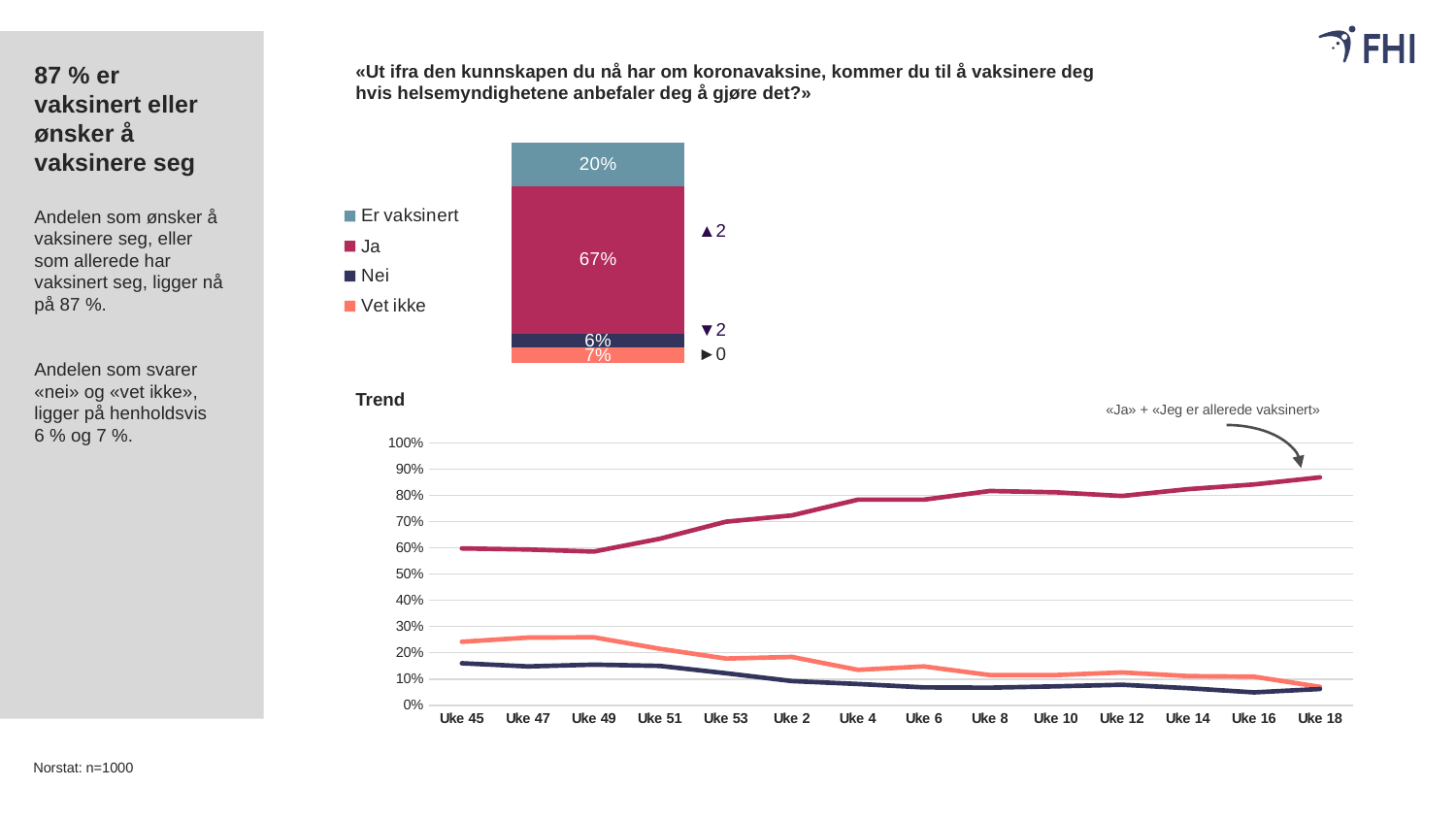
How many categories does the legend of the stacked bar chart list? 4 In the Trend chart, how many weeks are shown on the x axis? 14 In the stacked bar chart, what percentage answered "Ja"? 67% In the stacked bar chart, which category has the smallest share? Nei In the Trend chart, is the value of the top line ("Ja" + "Jeg er allerede vaksinert") at Uke 18 greater or less than 80%? greater In the stacked bar chart, what percentage answered "Vet ikke"? 7% In the stacked bar chart, what is the difference between the "Ja" share and the "Er vaksinert" share? 47 percentage points In the stacked bar chart, what percentage is shown for "Er vaksinert"? 20% In the Trend chart, does the top line ("Ja" + "Jeg er allerede vaksinert") generally rise or fall from Uke 45 to Uke 18? rise In the stacked bar chart, which category has the largest share? Ja In the stacked bar chart, what is the combined share of "Ja" and "Er vaksinert"? 87% In the stacked bar chart, what percentage answered "Nei"? 6%